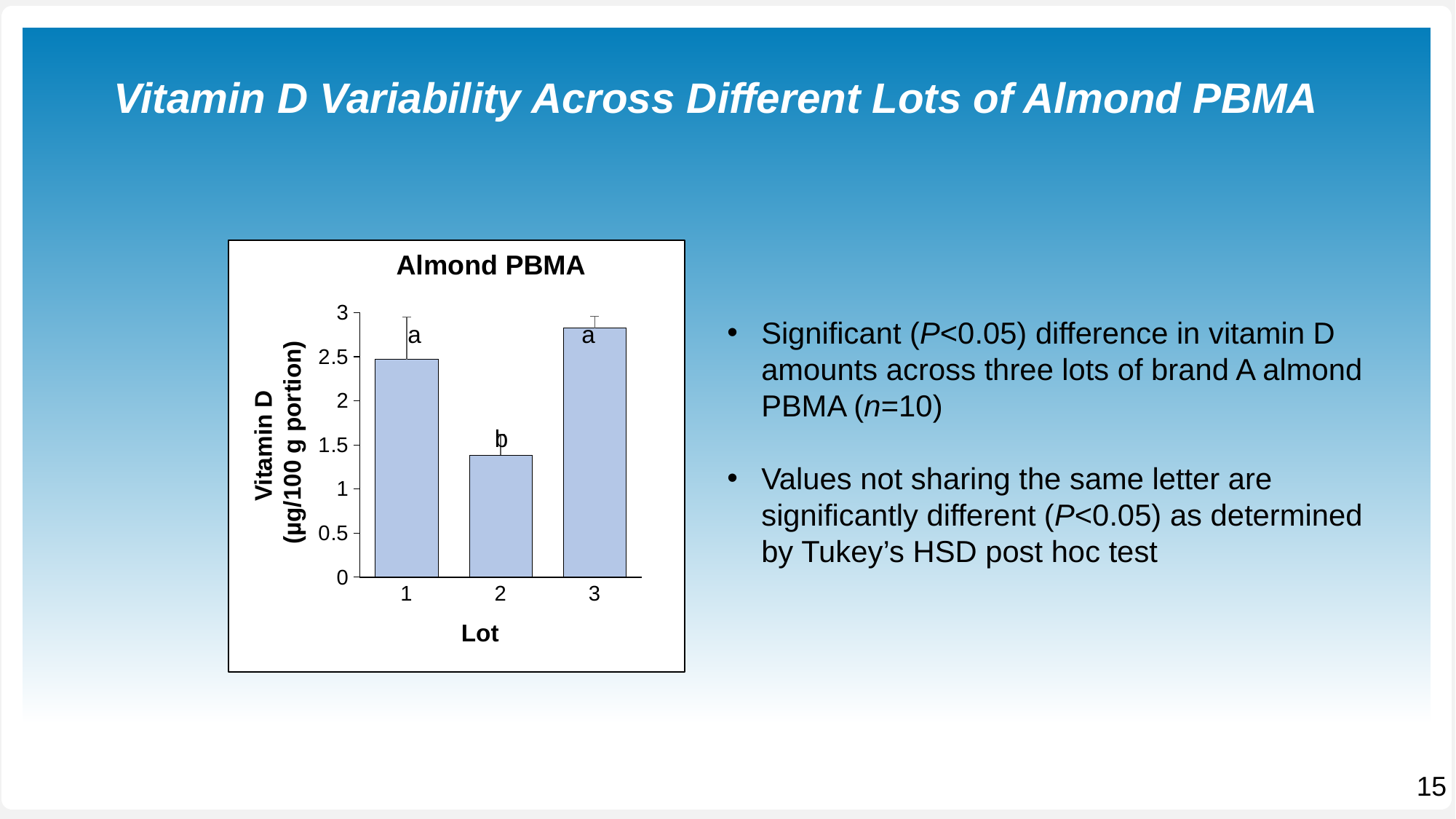
Is the vitamin D value for Lot 1 greater or less than 2? greater What kind of chart is shown on the slide? bar chart Is the vitamin D value for Lot 3 greater or less than 2.5? greater Which has a higher vitamin D value, Lot 1 or Lot 2? Lot 1 What is the title of the chart? Almond PBMA Is the vitamin D value for Lot 2 greater or less than 1.5? less Which has a higher vitamin D value, Lot 3 or Lot 1? Lot 3 How many lots are plotted in the Almond PBMA chart? 3 Which lot has the lowest vitamin D value in the Almond PBMA chart? Lot 2 Which lot has the highest vitamin D value in the Almond PBMA chart? Lot 3 What is the label on the x axis of the chart? Lot